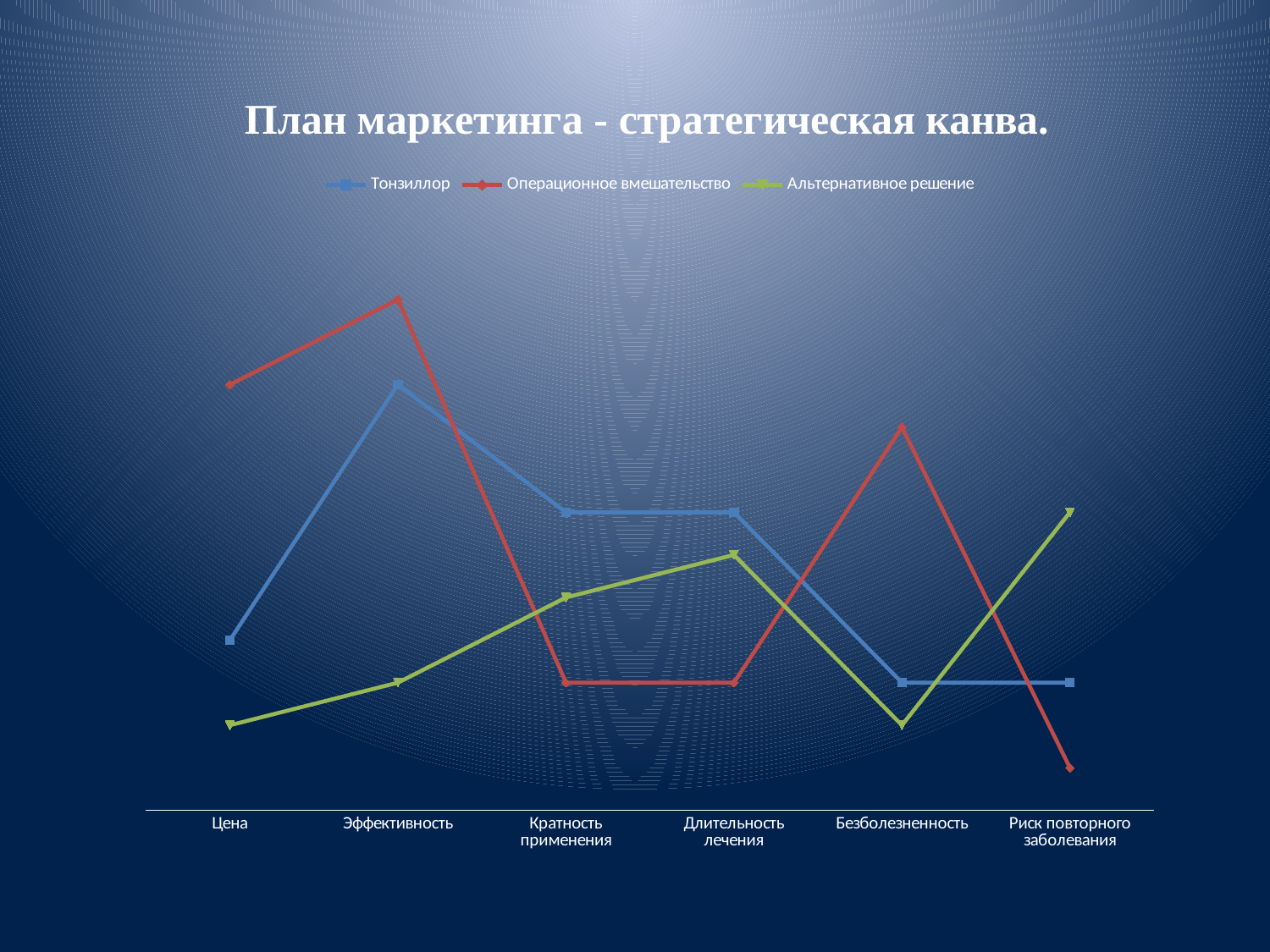
For which category does the Операционное вмешательство series reach its lowest value? Риск повторного заболевания At Цена, which series has the higher value: Тонзиллор or Операционное вмешательство? Операционное вмешательство How many series does the legend list? 3 At Кратность применения, which series has the higher value: Тонзиллор or Альтернативное решение? Тонзиллор Does the Альтернативное решение series rise or fall from Цена to Длительность лечения? Rise What kind of chart is shown on the slide? Line chart At Безболезненность, which of the three series has the highest value? Операционное вмешательство For which category does the Тонзиллор series reach its highest value? Эффективность What is the title of the chart? План маркетинга - стратегическая канва. For which category does the Операционное вмешательство series reach its highest value? Эффективность For which category does the Альтернативное решение series reach its highest value? Риск повторного заболевания How many categories are shown on the x axis? 6